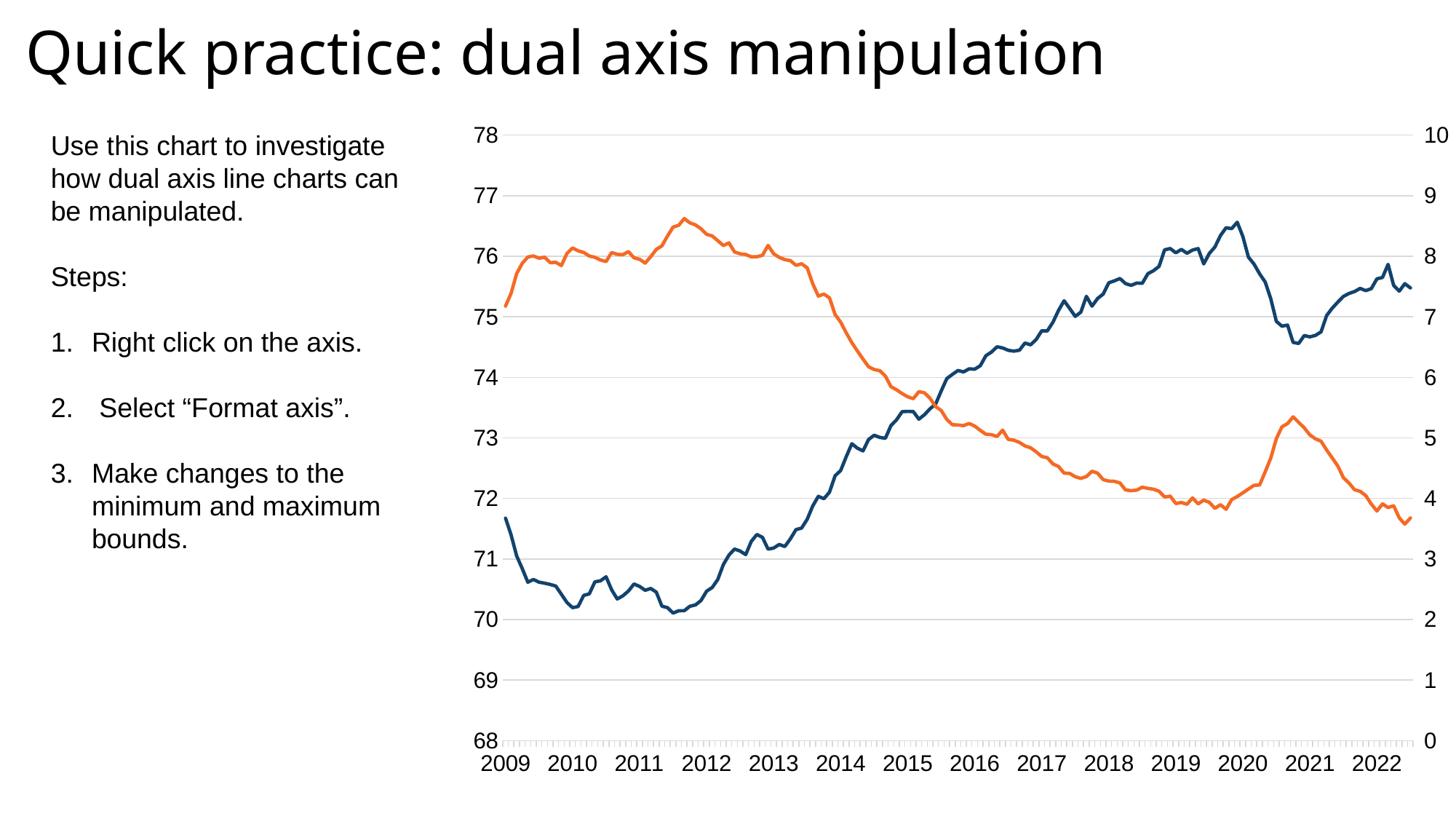
How many year labels are shown along the x axis of the chart? 14 What are the minimum and maximum values shown on the left-hand axis of the chart? 68 and 78 What kind of chart is shown on the slide? line chart Read against the right-hand axis, is the orange line at the end of 2022 greater or less than 4? less How many lines are plotted on the chart? 2 Read against the left-hand axis, is the peak of the orange line around 2011–2012 greater or less than 76? greater Which line is plotted higher on the chart in 2010, the dark blue line or the orange line? orange line Overall, does the orange line rise or fall from 2009 to 2022? falls What is the maximum value shown on the right-hand axis of the chart? 10 Read against the left-hand axis, is the dark blue line at the start of 2009 greater or less than 71? greater Which line is plotted higher on the chart in 2019, the dark blue line or the orange line? dark blue line Overall, does the dark blue line rise or fall from 2009 to 2022? rises